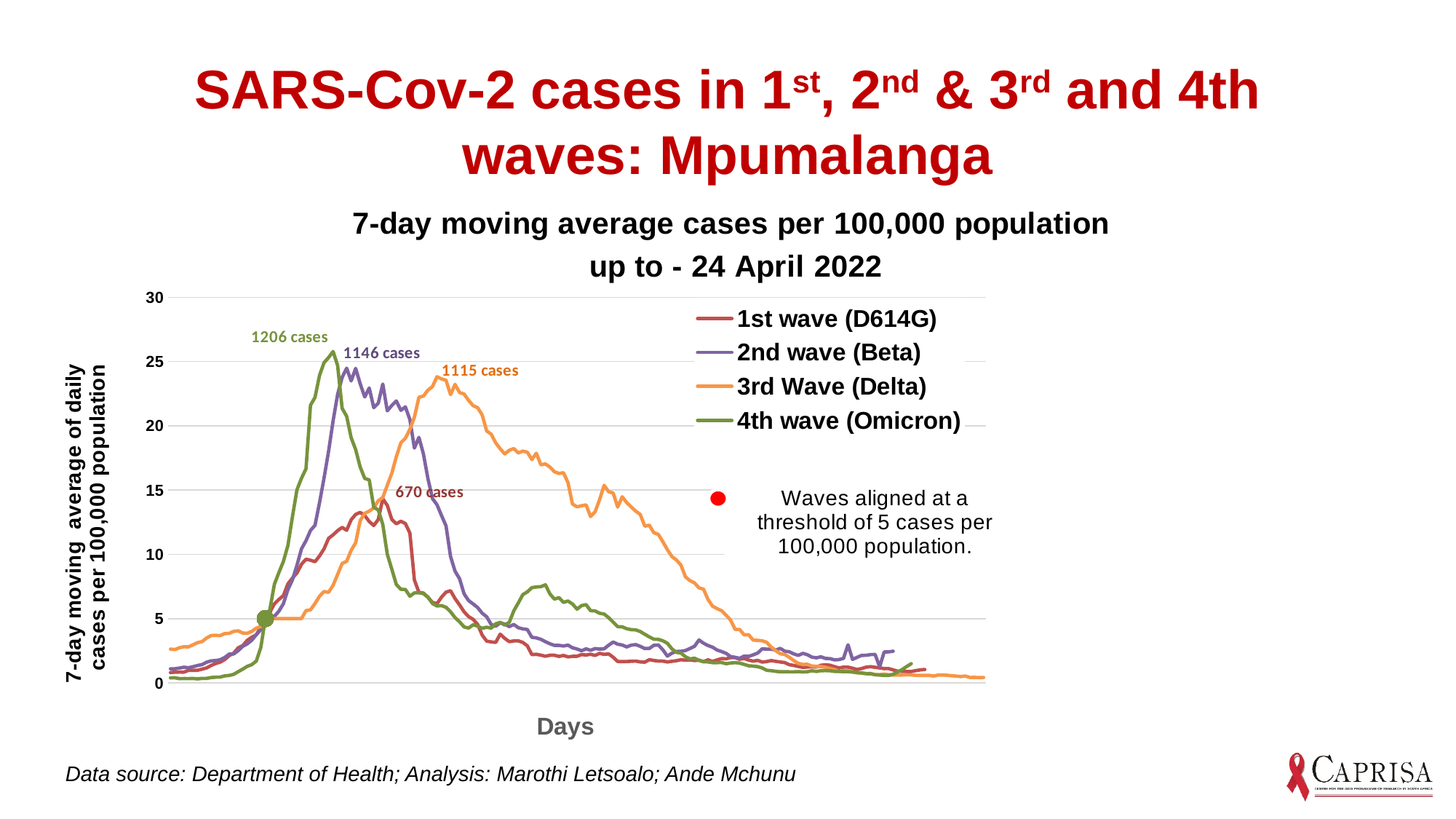
Which has a larger labelled peak case count, the 3rd Wave (Delta) or the 1st wave (D614G)? 3rd Wave (Delta) What is the difference between the labelled peak case counts of the 4th wave and the 2nd wave? 60 cases Which wave has the lowest labelled peak case count? 1st wave (D614G) How many cases are labelled at the peak of the 1st wave (D614G)? 670 cases What kind of chart is shown on the slide? line chart How many cases are labelled at the peak of the 4th wave (Omicron)? 1206 cases Which variant is associated with the 3rd Wave in the legend? Delta Is the peak 7-day moving average of the 1st wave (D614G) greater or less than 20? less How many cases are labelled at the peak of the 2nd wave (Beta)? 1146 cases How many series does the legend list? 4 Which wave has the highest labelled peak case count? 4th wave (Omicron) How many cases are labelled at the peak of the 3rd Wave (Delta)? 1115 cases